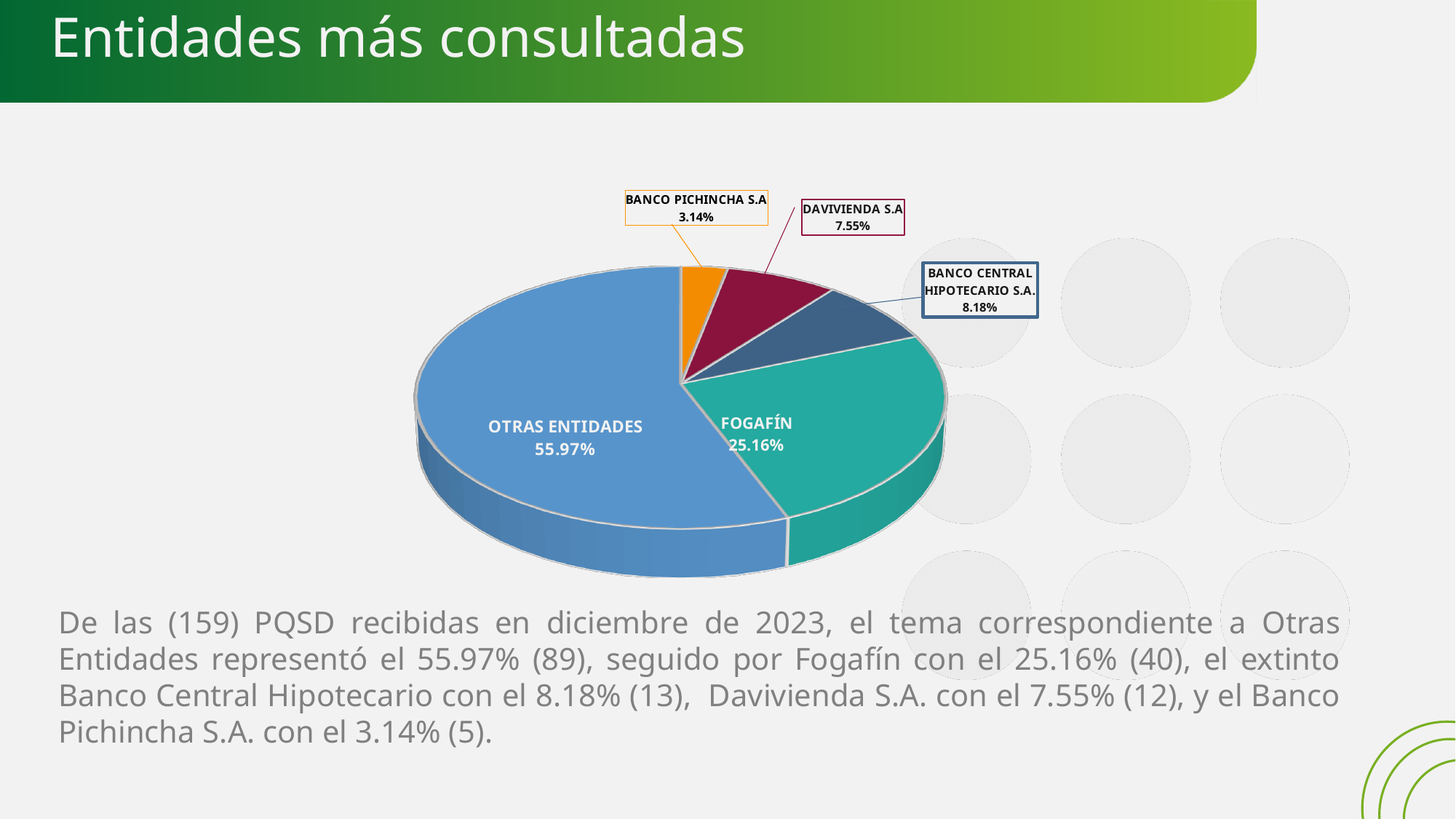
What is the difference in percentage points between OTRAS ENTIDADES and FOGAFÍN? 30.81 Which category has the smallest share of the pie chart? BANCO PICHINCHA S.A Which category has the largest share of the pie chart? OTRAS ENTIDADES What percentage does FOGAFÍN represent in the pie chart? 25.16% What type of chart is shown on the slide? Pie chart How many slices does the pie chart have? 5 What percentage is shown for BANCO CENTRAL HIPOTECARIO S.A.? 8.18% What percentage does OTRAS ENTIDADES represent in the pie chart? 55.97% What percentage is shown for BANCO PICHINCHA S.A? 3.14% What is the title of the slide containing the pie chart? Entidades más consultadas Which is larger, the share for DAVIVIENDA S.A or the share for BANCO CENTRAL HIPOTECARIO S.A.? BANCO CENTRAL HIPOTECARIO S.A. What percentage is shown for DAVIVIENDA S.A? 7.55%